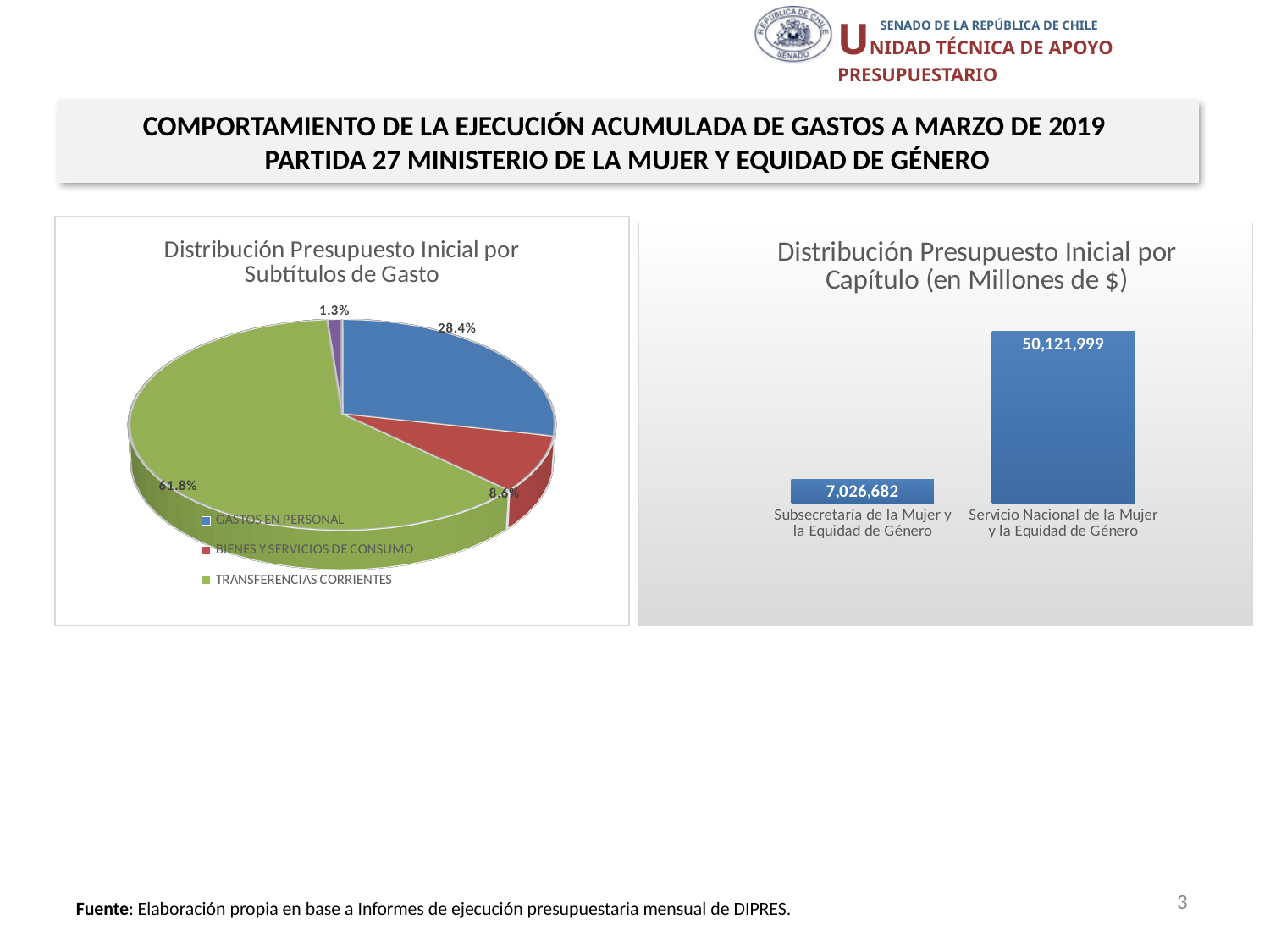
In the chart titled 'Distribución Presupuesto Inicial por Subtítulos de Gasto', what kind of chart is shown? Pie chart In the chart titled 'Distribución Presupuesto Inicial por Subtítulos de Gasto', how many entries does the legend list? 3 In the chart titled 'Distribución Presupuesto Inicial por Capítulo (en Millones de $)', how many categories are shown? 2 In the chart titled 'Distribución Presupuesto Inicial por Subtítulos de Gasto', which is larger: GASTOS EN PERSONAL or BIENES Y SERVICIOS DE CONSUMO? GASTOS EN PERSONAL In the chart titled 'Distribución Presupuesto Inicial por Capítulo (en Millones de $)', what is the value for Servicio Nacional de la Mujer y la Equidad de Género? 50,121,999 In the chart titled 'Distribución Presupuesto Inicial por Capítulo (en Millones de $)', what is the difference between the two bars? 43,095,317 In the chart titled 'Distribución Presupuesto Inicial por Subtítulos de Gasto', what share does TRANSFERENCIAS CORRIENTES have? 61.8% In the chart titled 'Distribución Presupuesto Inicial por Capítulo (en Millones de $)', what kind of chart is shown? Bar chart In the chart titled 'Distribución Presupuesto Inicial por Subtítulos de Gasto', what share does BIENES Y SERVICIOS DE CONSUMO have? 8.6% In the chart titled 'Distribución Presupuesto Inicial por Capítulo (en Millones de $)', what is the value for Subsecretaría de la Mujer y la Equidad de Género? 7,026,682 In the chart titled 'Distribución Presupuesto Inicial por Subtítulos de Gasto', what share does GASTOS EN PERSONAL have? 28.4% In the chart titled 'Distribución Presupuesto Inicial por Subtítulos de Gasto', which category has the largest slice? TRANSFERENCIAS CORRIENTES